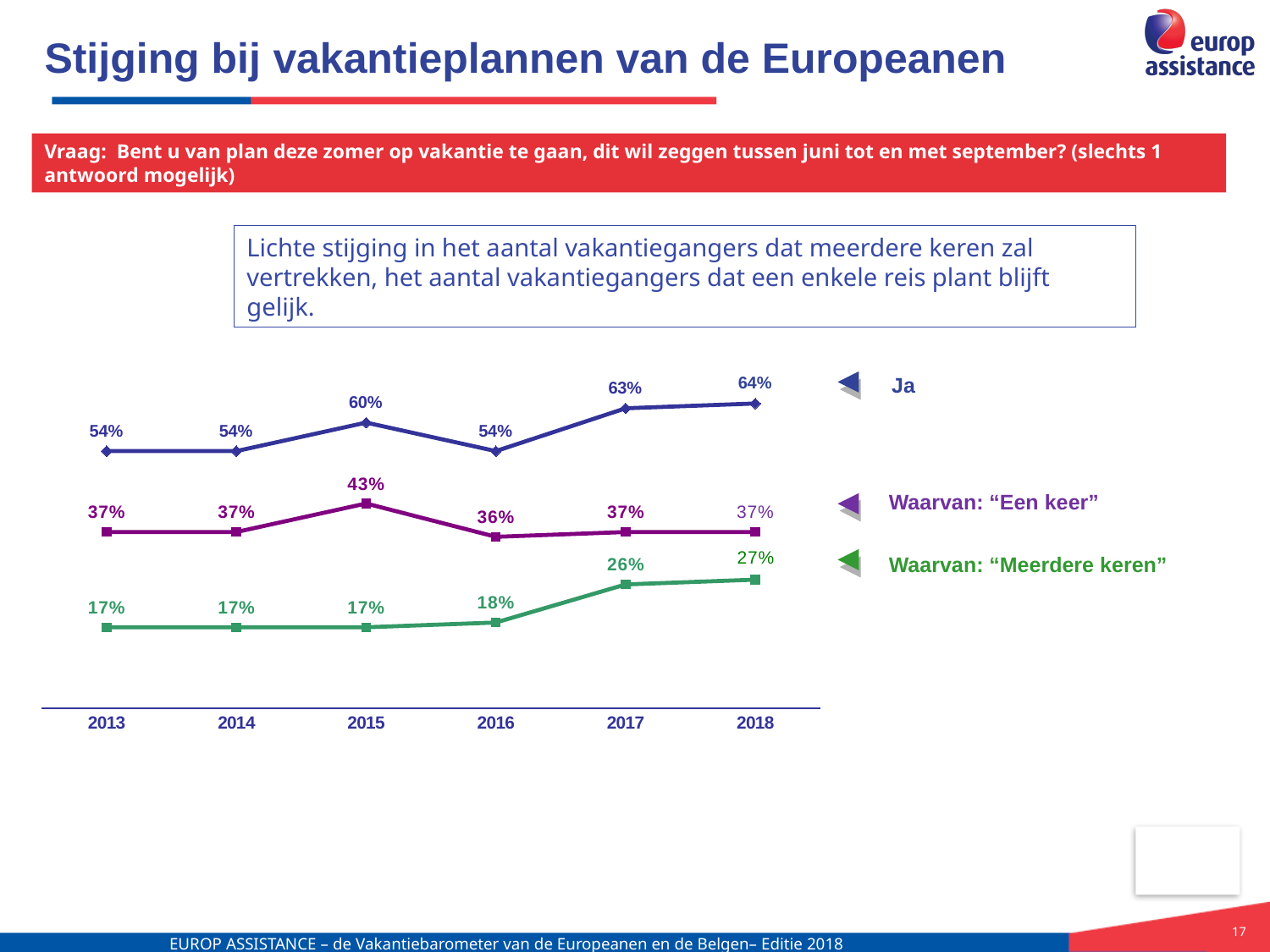
What is the value for "Waarvan: "Een keer"" in 2015? 43% What is the difference between the "Ja" values for 2018 and 2013? 10% How many years are shown on the x axis? 6 Which is larger: "Waarvan: "Meerdere keren"" in 2018 or in 2016? 2018 In which year is the "Waarvan: "Een keer"" series lowest? 2016 Does the "Waarvan: "Meerdere keren"" series rise or fall from 2016 to 2018? rise What colour is the line for the "Ja" series? blue How many series does the legend list? 3 In which year is the "Ja" series highest? 2018 What kind of chart is shown on the slide? line chart What is the value for "Waarvan: "Meerdere keren"" in 2017? 26% What is the value for "Ja" in 2018? 64%